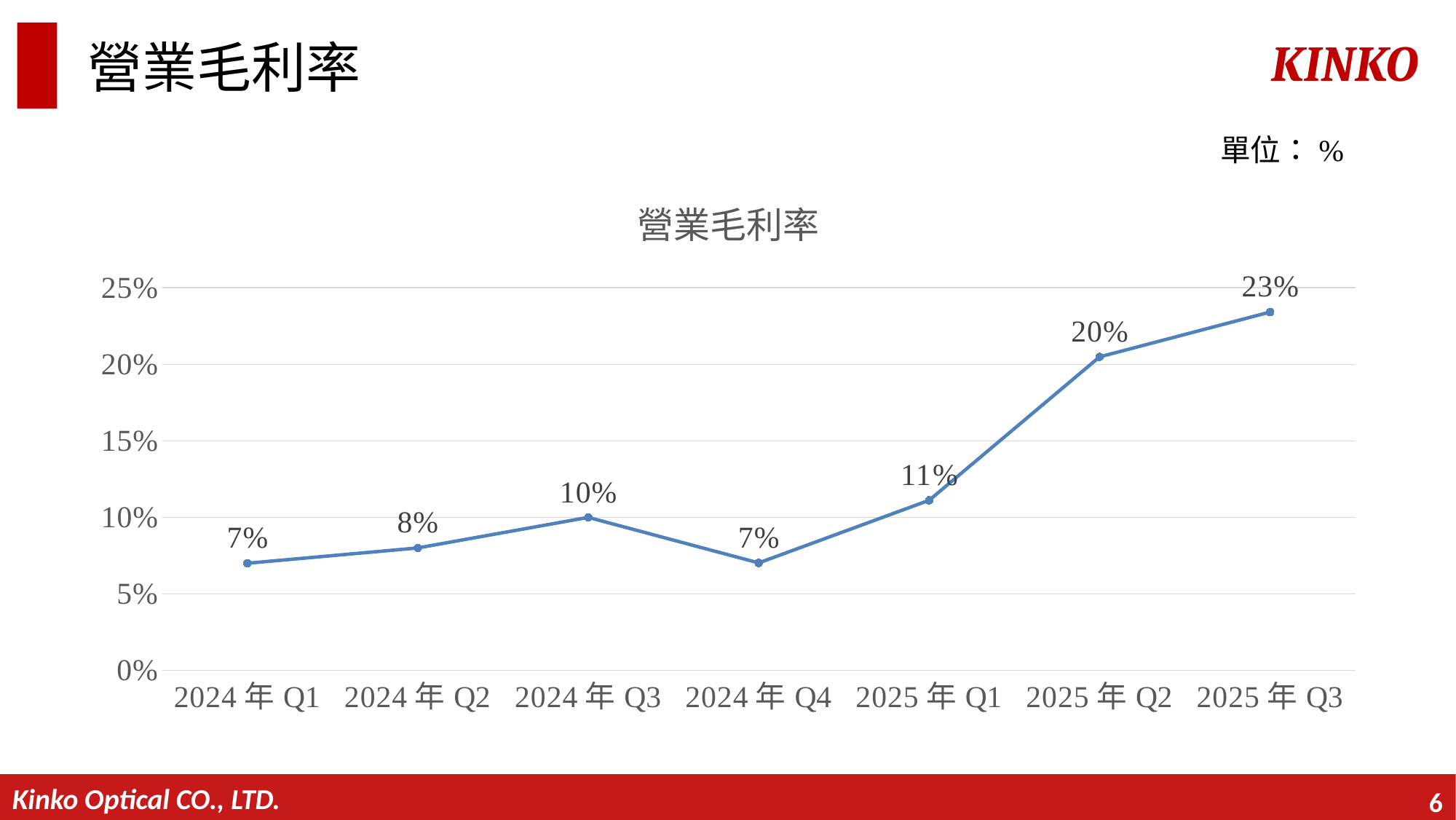
How many quarters are plotted on the chart? 7 Which quarter has the highest value? 2025 年 Q3 What is the value for 2025 年 Q2? 20% What is the difference between the values for 2025 年 Q2 and 2025 年 Q1? 9% Is the value for 2025 年 Q2 greater or less than 15%? greater What kind of chart is shown on the slide? line chart What is the value for 2024 年 Q3? 10% What is the title of the chart? 營業毛利率 What is the difference between the values for 2025 年 Q3 and 2024 年 Q4? 16% Do the values rise or fall from 2024 年 Q4 to 2025 年 Q3? rise Which is larger, the value for 2024 年 Q3 or the value for 2024 年 Q4? 2024 年 Q3 What is the value for 2025 年 Q1? 11%